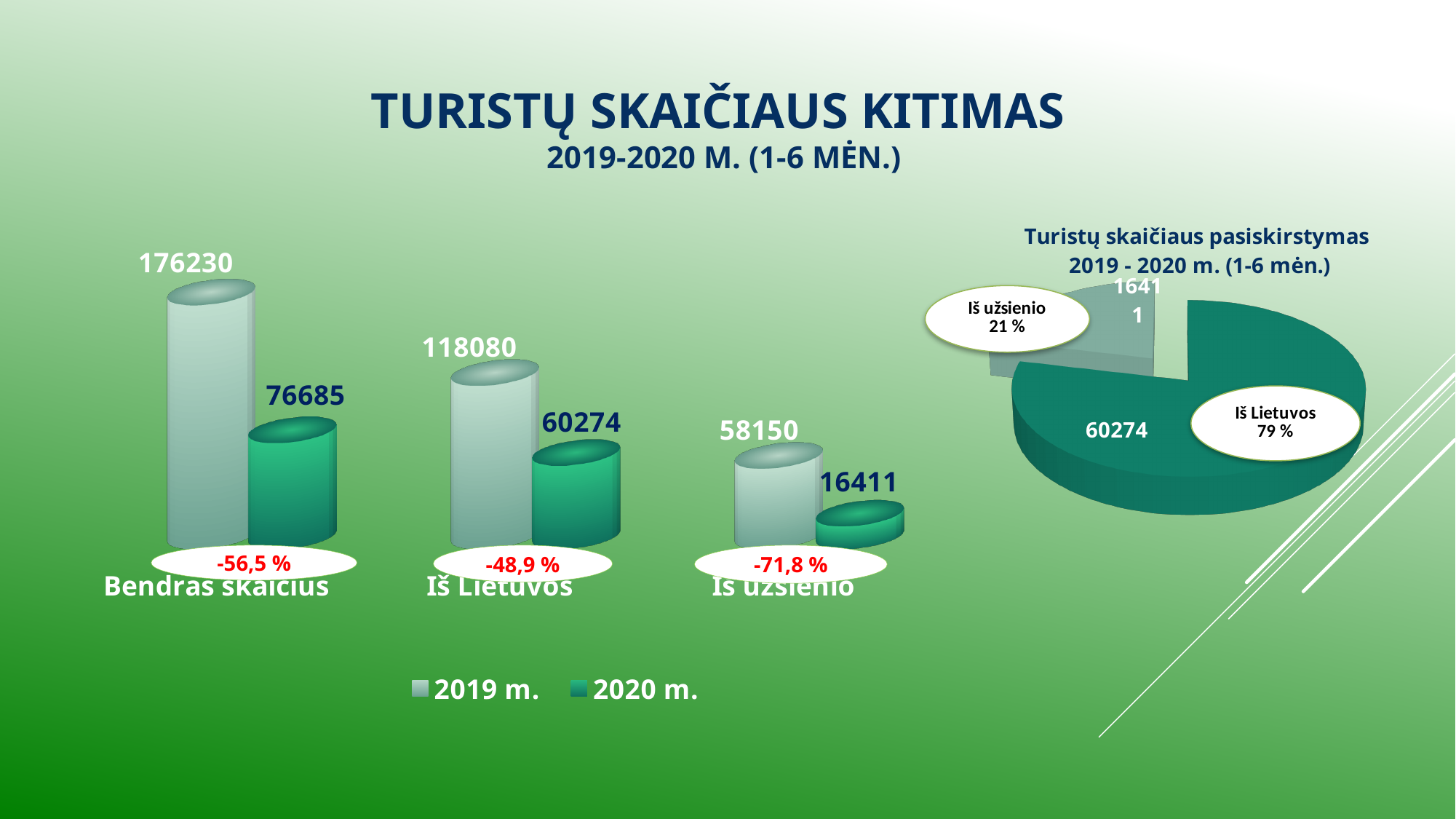
In the bar chart on the left, which is larger: the 2020 m. value for Iš Lietuvos or the 2019 m. value for Iš užsienio? 2020 m. value for Iš Lietuvos In the bar chart on the left, what is the value for Iš Lietuvos in 2020 m.? 60274 In the bar chart on the left, what is the value for Iš užsienio in 2019 m.? 58150 In the pie chart titled 'Turistų skaičiaus pasiskirstymas', what share does Iš Lietuvos have? 79 % In the bar chart on the left, what is the difference between the 2019 m. and 2020 m. values for Bendras skaičius? 99545 How many categories are shown in the bar chart on the left? 3 In the bar chart on the left, which category has the highest value for 2019 m.? Bendras skaičius In the bar chart on the left, what percentage change is shown for Iš užsienio? -71,8 % In the bar chart on the left, which category has the lowest value for 2020 m.? Iš užsienio How many series does the legend of the bar chart on the left list? 2 What kind of chart is the chart on the right of the slide? Pie chart In the bar chart on the left, what is the value for Bendras skaičius in 2019 m.? 176230